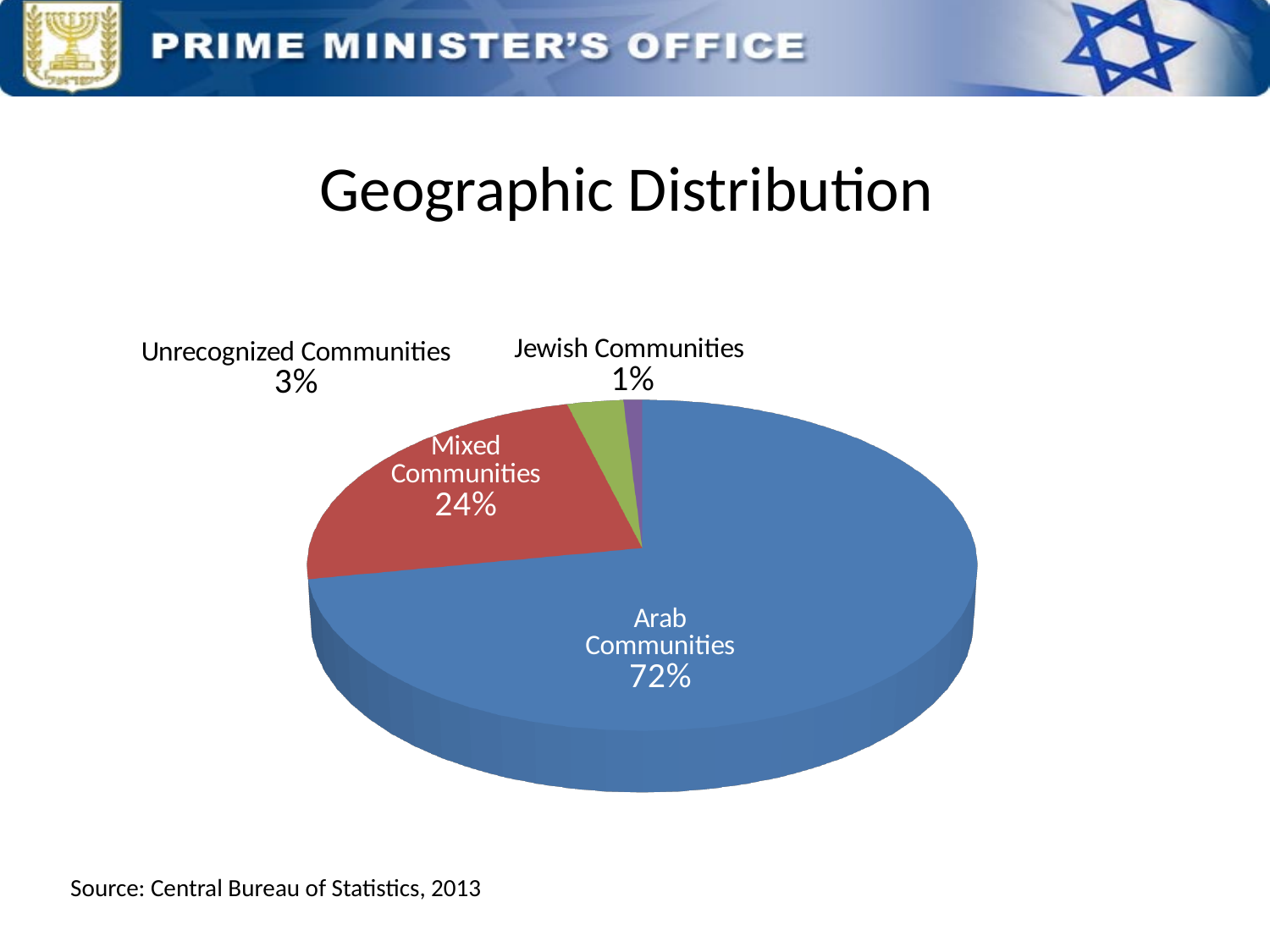
What is the title of the chart? Geographic Distribution How many slices does the pie chart have? 4 What share of the pie is Unrecognized Communities? 3% What share of the pie is Jewish Communities? 1% Which is larger, the share for Mixed Communities or the share for Unrecognized Communities? Mixed Communities What share of the pie is Arab Communities? 72% What is the difference in percentage points between Arab Communities and Mixed Communities? 48 What colour is the Mixed Communities slice? Red What kind of chart is shown on the slide? Pie chart Which category has the largest slice of the pie? Arab Communities Which category has the smallest slice of the pie? Jewish Communities